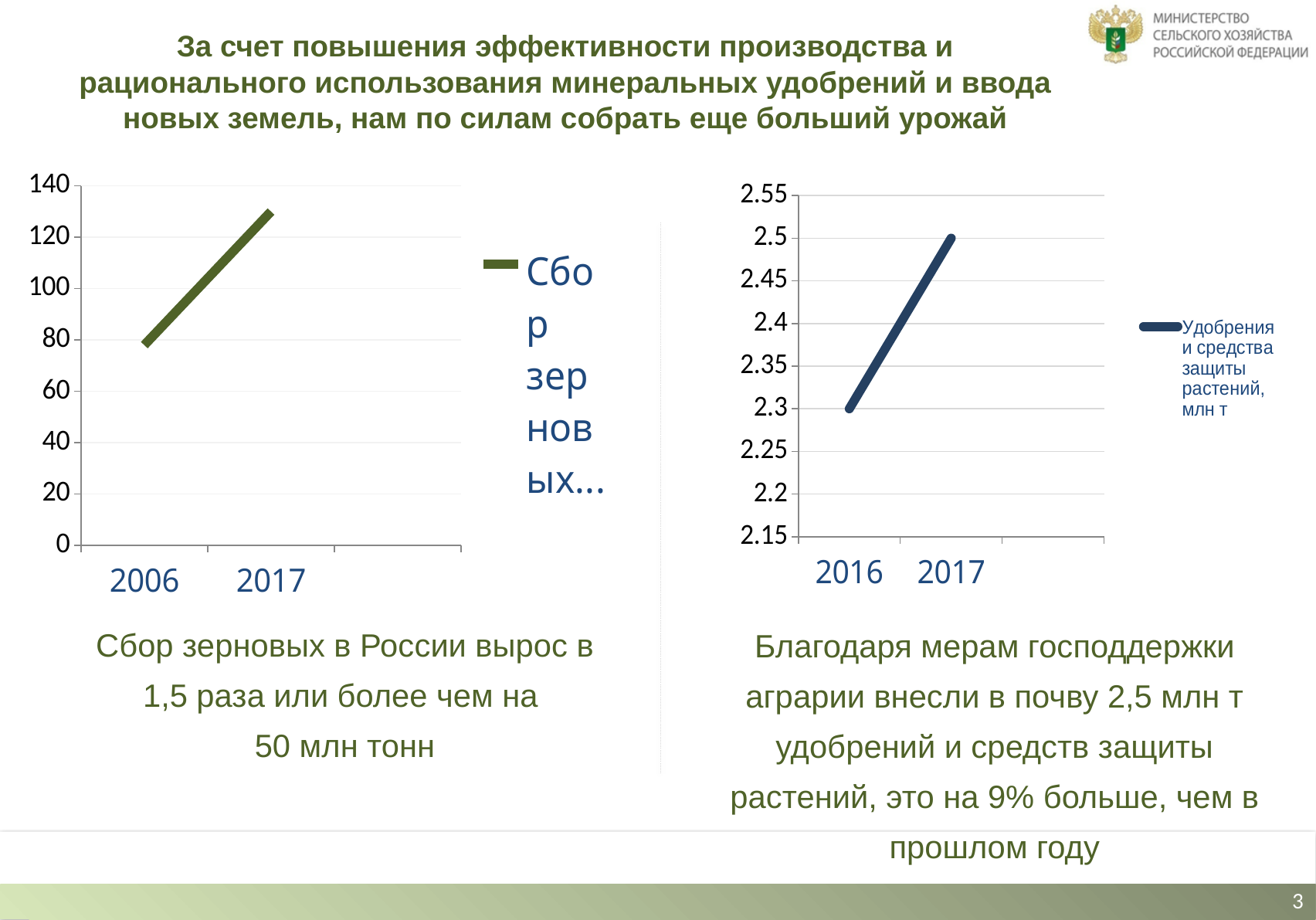
What kind of chart is the left chart on the slide? line chart In the right chart, does the value rise or fall from 2016 to 2017? rise In the right chart, what is the value for 2017? 2.5 In the left chart, is the value for 2017 greater or less than 120? greater In the right chart, which year has the higher value, 2016 or 2017? 2017 In the left chart, does the value rise or fall from 2006 to 2017? rise In the right chart, what is the difference between the values for 2017 and 2016? 0.2 In the left chart, is the value for 2006 greater or less than 100? less How many series does the legend of the right chart list? 1 What kind of chart is the right chart on the slide? line chart In the left chart, is the value for 2006 greater or less than 60? greater In the right chart, what is the value for 2016? 2.3